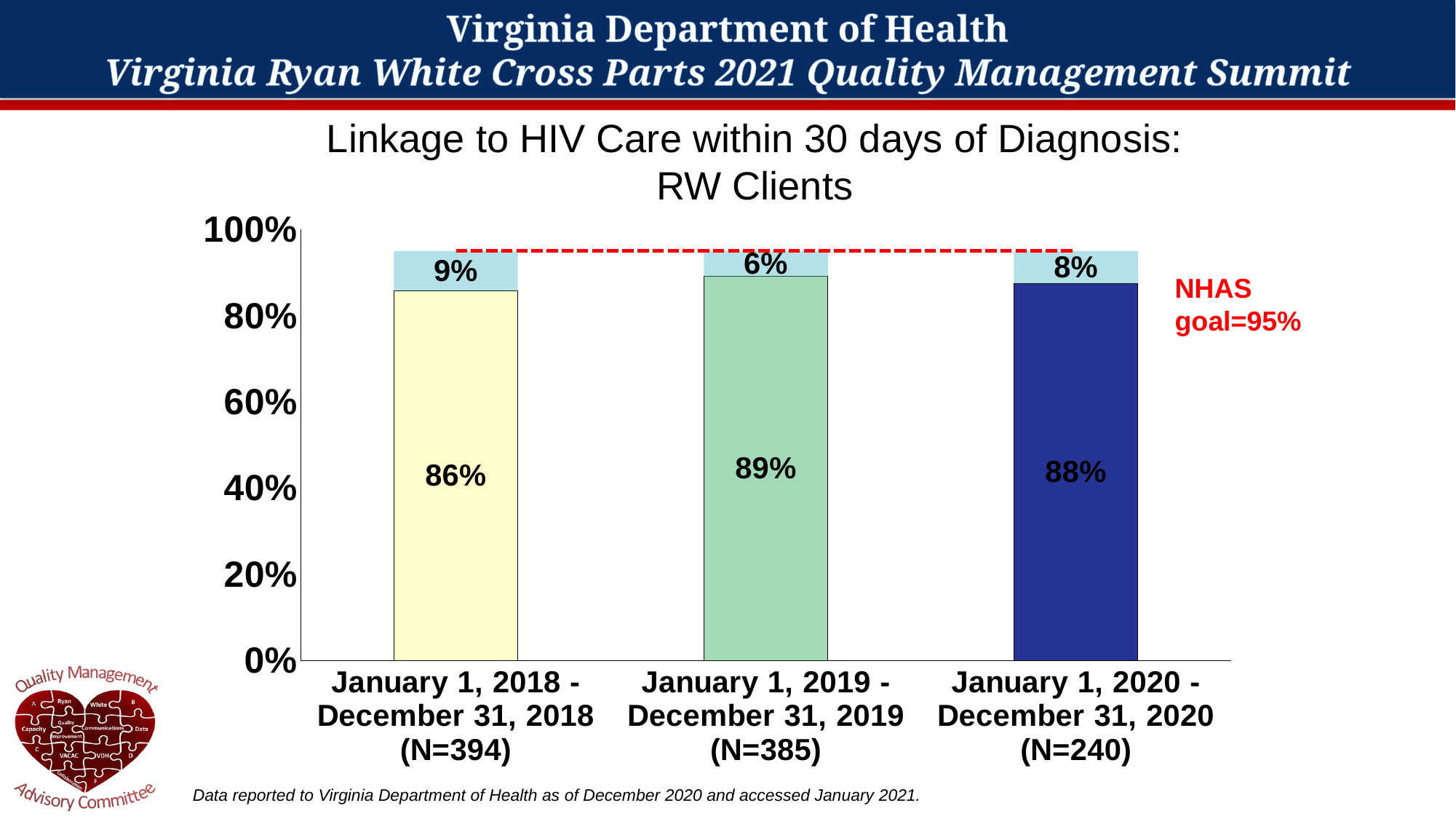
What is the total of the stacked bar for January 1, 2020 - December 31, 2020 (N=240)? 96% Which period has the highest value for the lower bar segment? January 1, 2019 - December 31, 2019 (N=385) What NHAS goal is indicated by the red dashed line? 95% Which period has the lowest value for the upper bar segment? January 1, 2019 - December 31, 2019 (N=385) What is the value of the lower segment of the bar for January 1, 2019 - December 31, 2019 (N=385)? 89% How many time periods are shown on the x axis? 3 What is the value of the upper segment of the bar for January 1, 2019 - December 31, 2019 (N=385)? 6% Is the lower segment value for the 2020 period larger or smaller than that for the 2018 period? larger What is the value of the lower segment of the bar for January 1, 2018 - December 31, 2018 (N=394)? 86% What kind of chart is shown on the slide? Stacked bar chart What is the difference between the lower segment values for the 2019 period and the 2018 period? 3% What is the value of the upper segment of the bar for January 1, 2020 - December 31, 2020 (N=240)? 8%